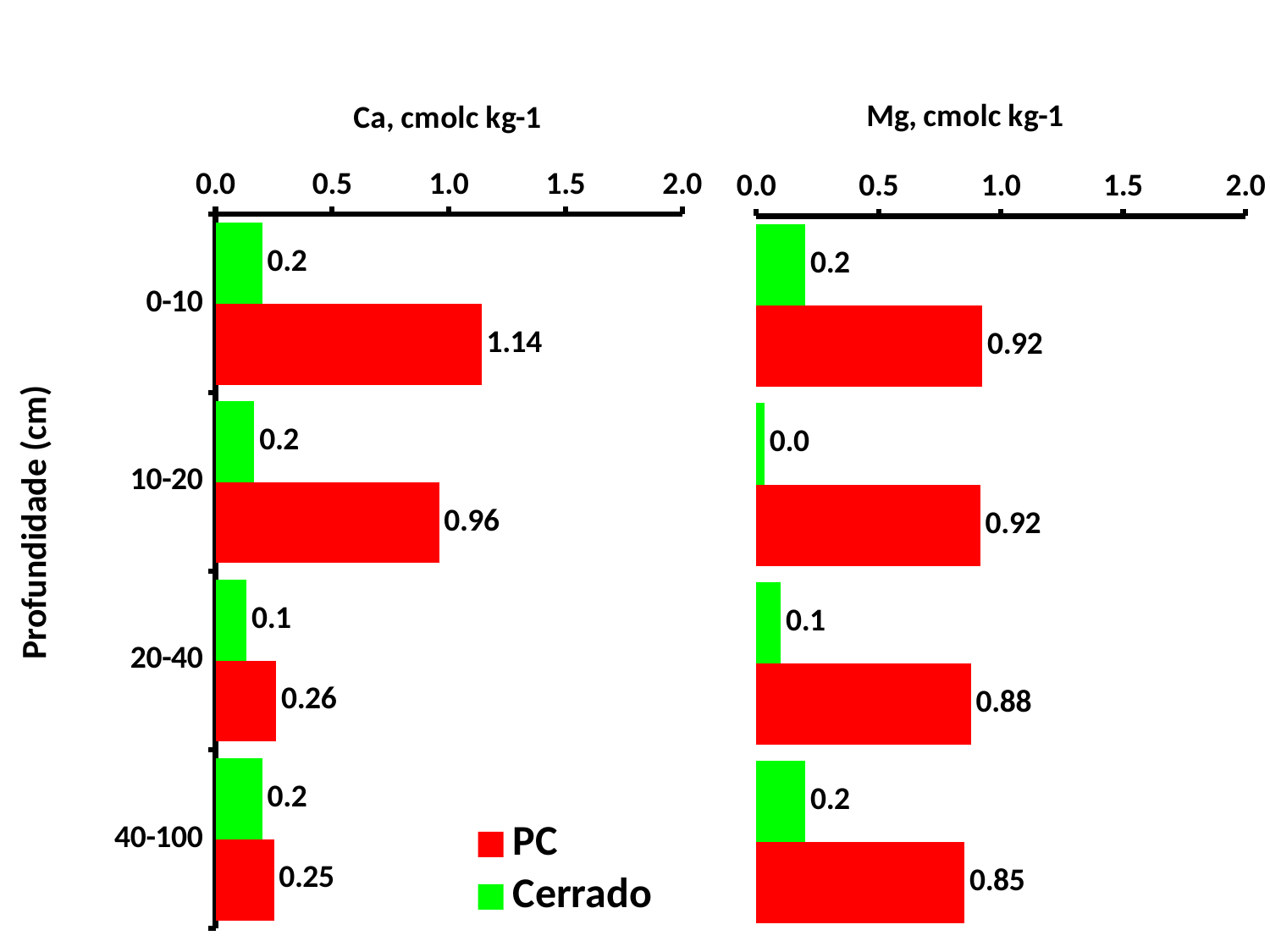
How many series does the legend list? 2 In the Mg, cmolc kg-1 chart, what is the PC value for the 40-100 cm depth? 0.85 In the Ca, cmolc kg-1 chart, what is the difference between the PC values for 0-10 cm and 10-20 cm? 0.18 In the Ca, cmolc kg-1 chart, which depth has the lowest PC value? 40-100 In the Ca, cmolc kg-1 chart, which depth has the highest PC value? 0-10 In the Mg, cmolc kg-1 chart, which depth has the lowest PC value? 40-100 In the Mg, cmolc kg-1 chart, what is the difference between the PC and Cerrado values for the 20-40 cm depth? 0.78 How many depth categories are shown in the Ca, cmolc kg-1 chart? 4 In the Ca, cmolc kg-1 chart, what is the PC value for the 0-10 cm depth? 1.14 In the Ca, cmolc kg-1 chart, which is larger for the 20-40 cm depth, PC or Cerrado? PC In the Mg, cmolc kg-1 chart, what is the Cerrado value for the 10-20 cm depth? 0.0 What type of chart is the Mg, cmolc kg-1 chart? Bar chart